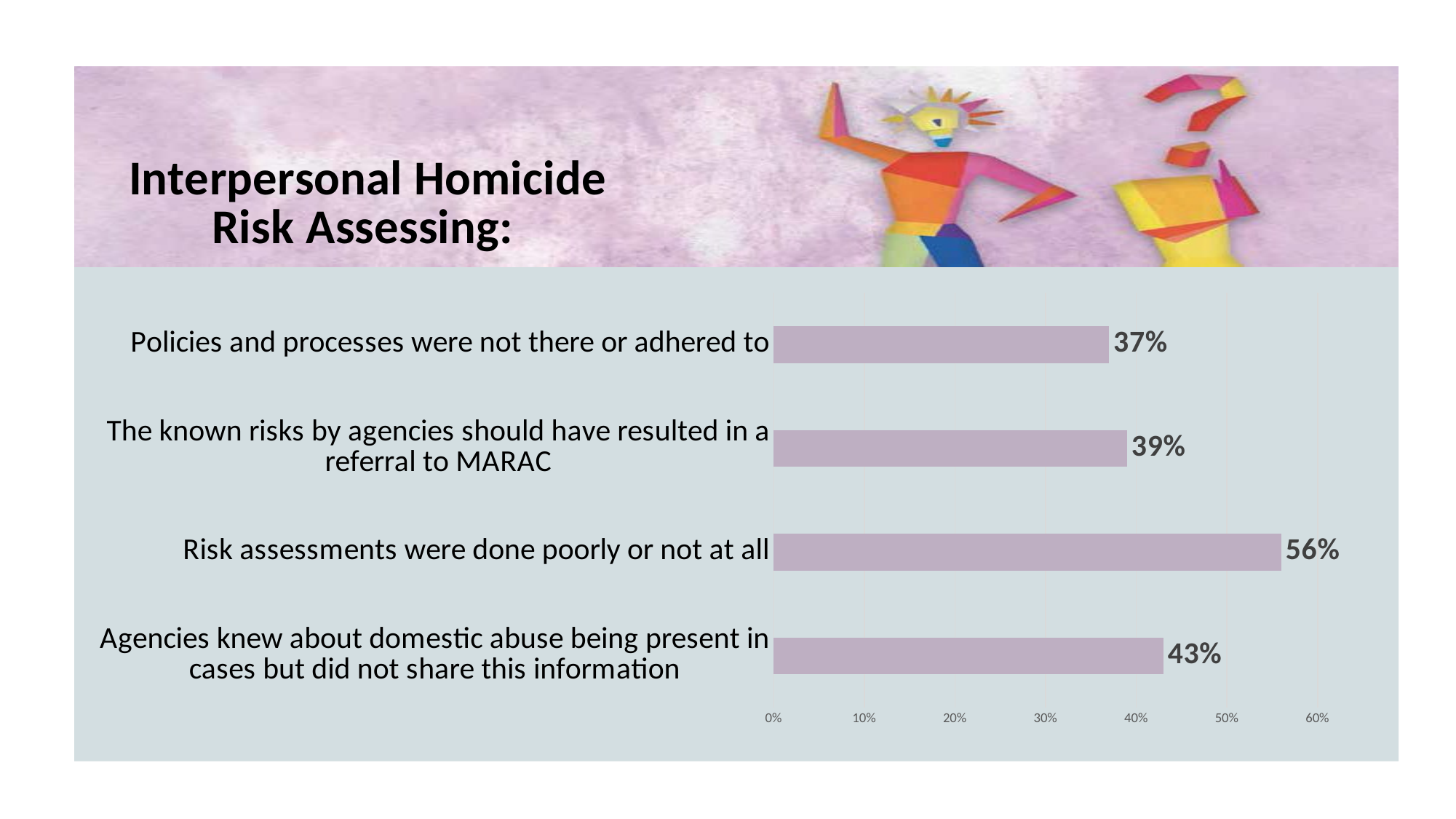
What kind of chart is shown on the slide? Bar chart Which category has the lowest value? Policies and processes were not there or adhered to What is the difference between the value for 'Risk assessments were done poorly or not at all' and the value for 'Agencies knew about domestic abuse being present in cases but did not share this information'? 13% How many categories are shown in the chart? 4 What is the value for 'Agencies knew about domestic abuse being present in cases but did not share this information'? 43% What is the value for 'Policies and processes were not there or adhered to'? 37% What is the value for 'Risk assessments were done poorly or not at all'? 56% What is the value for 'The known risks by agencies should have resulted in a referral to MARAC'? 39% Which is larger: the value for 'The known risks by agencies should have resulted in a referral to MARAC' or the value for 'Policies and processes were not there or adhered to'? The known risks by agencies should have resulted in a referral to MARAC Which category has the highest value? Risk assessments were done poorly or not at all What is the title of the slide containing the chart? Interpersonal Homicide Risk Assessing: Is the value for 'Risk assessments were done poorly or not at all' greater or less than 50%? greater